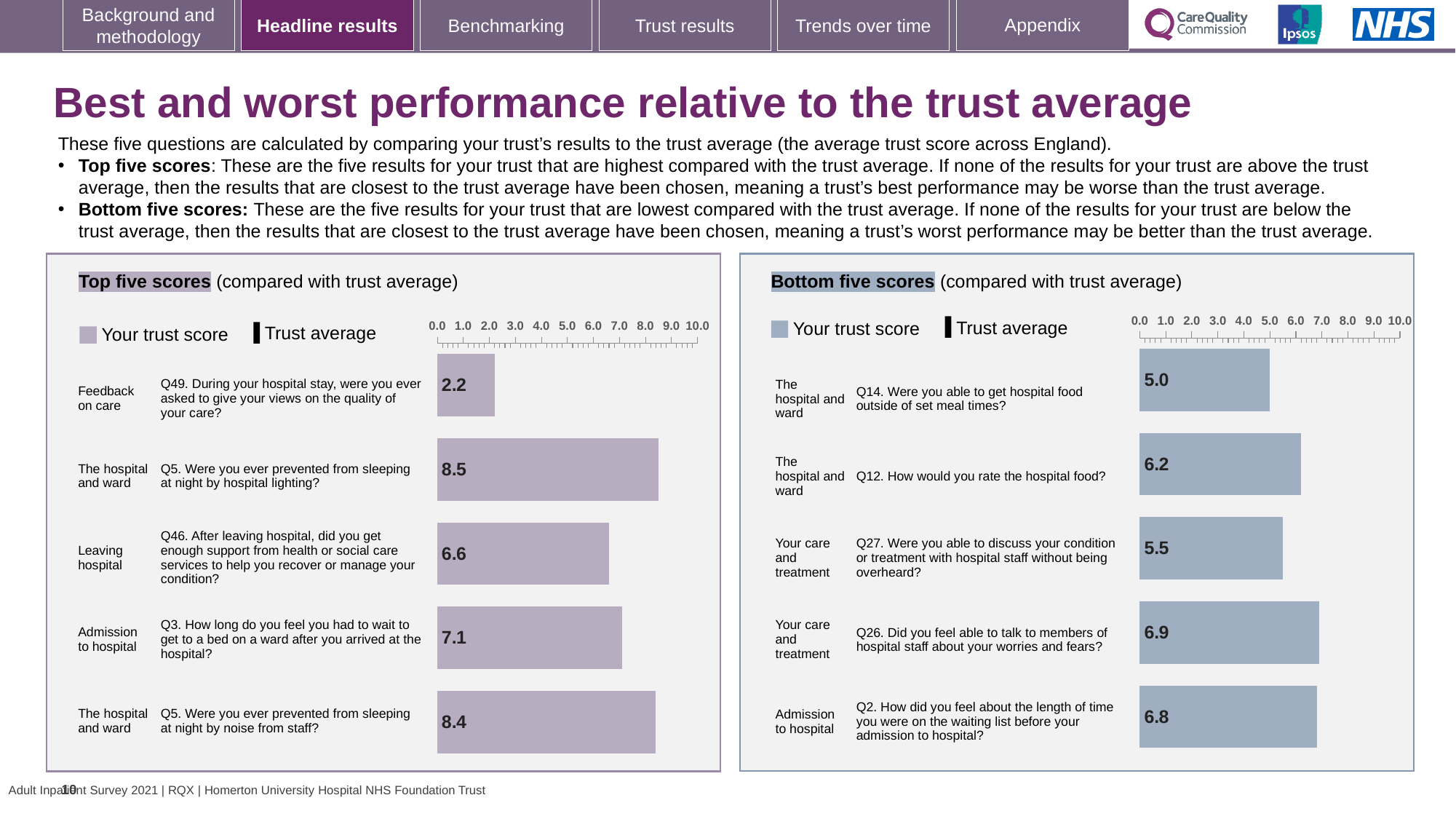
In the Top five scores chart, what is the trust score for Q49 (asked to give your views on the quality of your care)? 2.2 In the Bottom five scores chart, what is the trust score for Q12 (How would you rate the hospital food?)? 6.2 In the Top five scores chart, which question has the lowest trust score? Q49. During your hospital stay, were you ever asked to give your views on the quality of your care? In the Bottom five scores chart, what is the difference between the trust scores for Q26 (6.9) and Q14 (5.0)? 1.9 What type of chart is the Top five scores chart? Bar chart In the Top five scores chart, which has the larger trust score: Q46 (support after leaving hospital) or Q3 (wait to get to a bed on a ward)? Q3 (7.1) How many entries does the legend of the Bottom five scores chart list? 2 In the Bottom five scores chart, which question has the lowest trust score? Q14. Were you able to get hospital food outside of set meal times? In the Bottom five scores chart, what is the trust score for Q2 about the length of time on the waiting list before admission? 6.8 In the Top five scores chart, what is the trust score for Q5 about being prevented from sleeping at night by hospital lighting? 8.5 How many questions are plotted in the Bottom five scores chart? 5 In the Top five scores chart, which question has the highest trust score? Q5. Were you ever prevented from sleeping at night by hospital lighting?